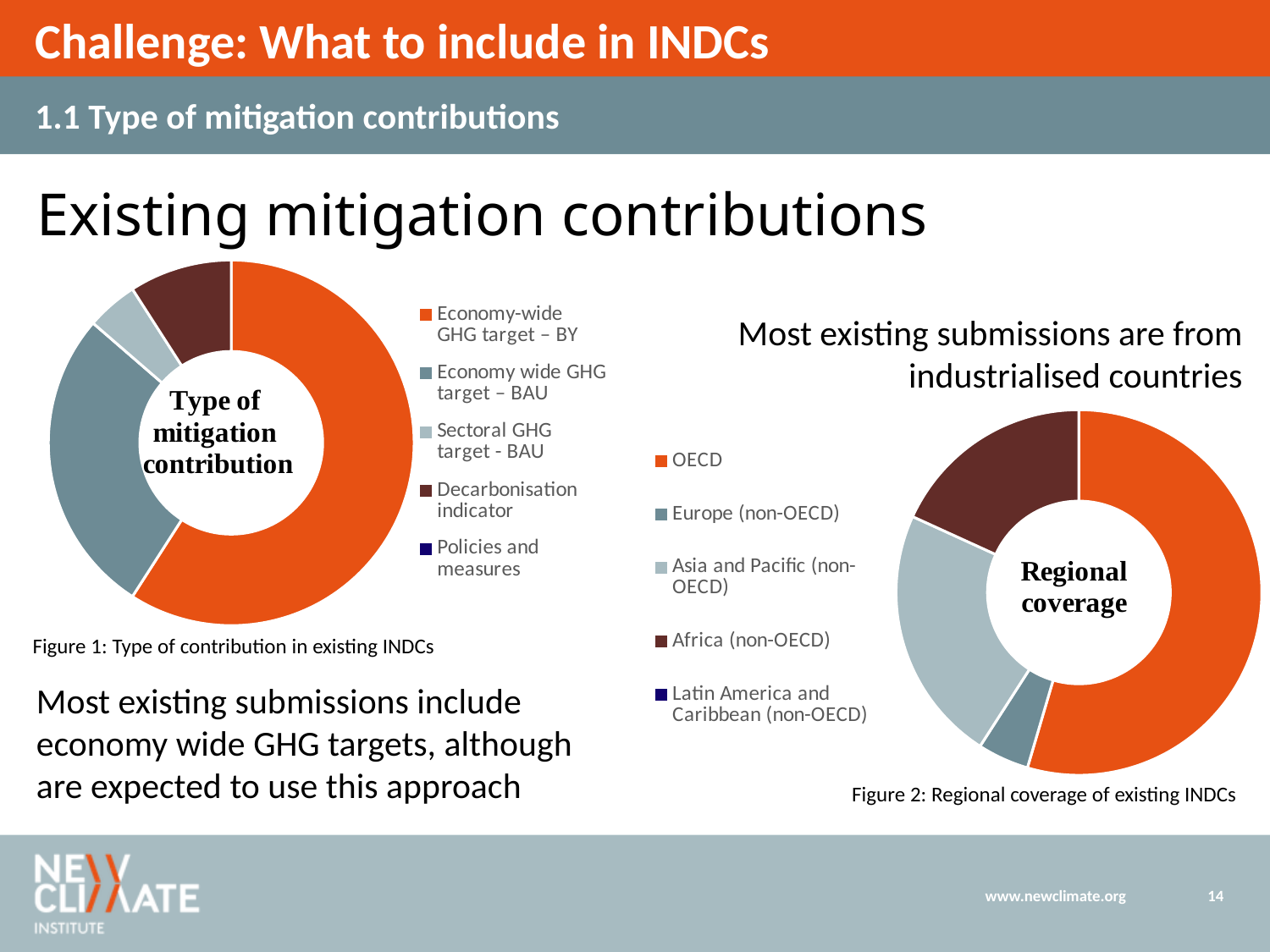
In Figure 1 (Type of mitigation contribution), which slice is larger: Economy-wide GHG target – BY or Decarbonisation indicator? Economy-wide GHG target – BY In Figure 2 (Regional coverage), which slice is larger: Asia and Pacific (non-OECD) or Europe (non-OECD)? Asia and Pacific (non-OECD) In Figure 2 (Regional coverage), which slice is larger: OECD or Africa (non-OECD)? OECD In Figure 2 (Regional coverage), which region has the largest slice? OECD In Figure 2 (Regional coverage), how many categories does the legend list? 5 What is the caption of the chart on the left of the slide? Figure 1: Type of contribution in existing INDCs In Figure 2 (Regional coverage), what colour represents OECD? Orange What kind of chart is Figure 1 (Type of mitigation contribution)? Doughnut (pie) chart What kind of chart is Figure 2 (Regional coverage)? Doughnut (pie) chart In Figure 1 (Type of mitigation contribution), which category has the largest slice? Economy-wide GHG target – BY In Figure 1 (Type of mitigation contribution), how many categories does the legend list? 5